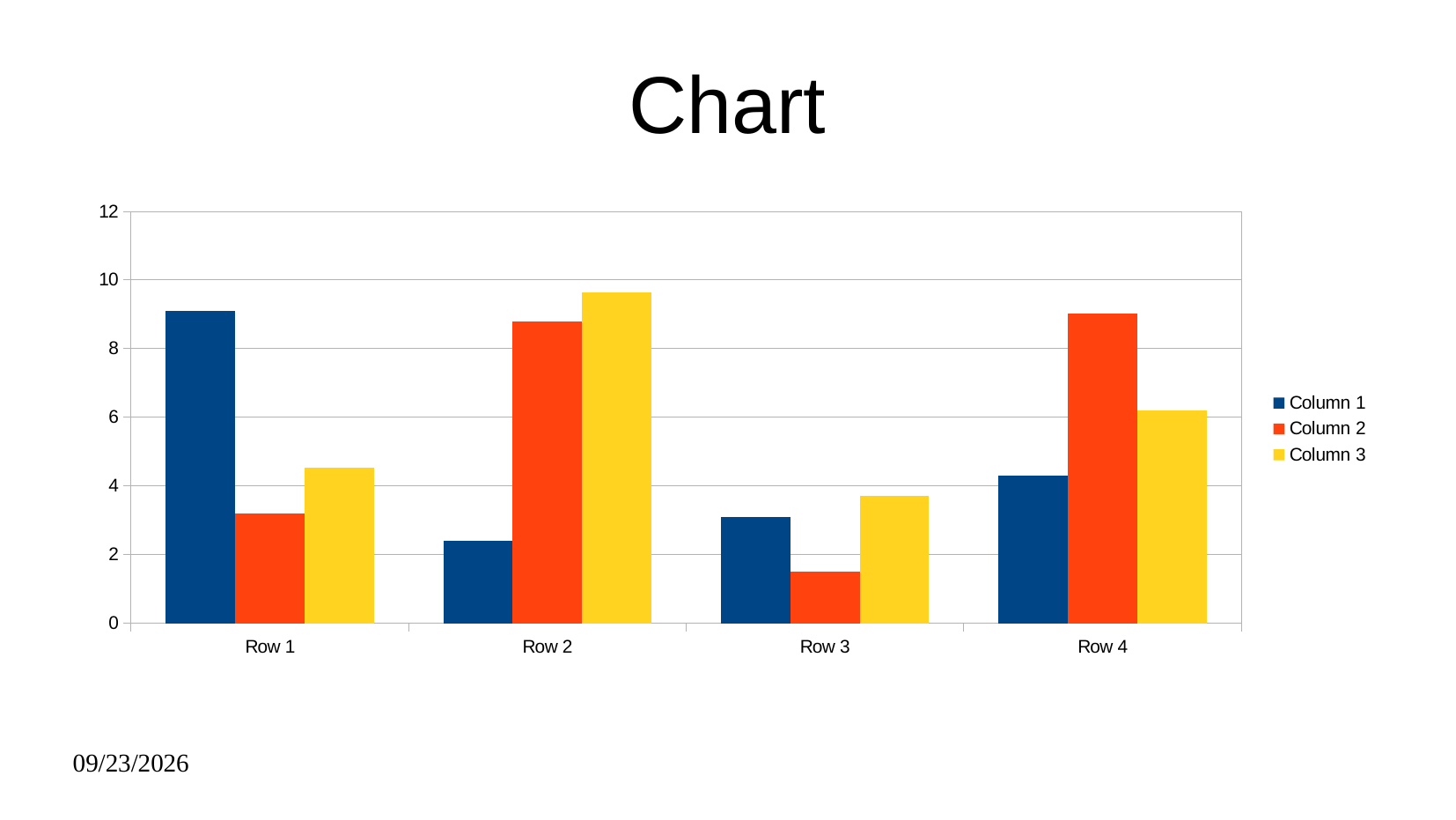
Is the value for Column 2 in Row 4 greater or less than 8? greater Which category has the highest value for Column 3? Row 2 What is the title of the chart? Chart In Row 2, which is larger: Column 1 or Column 3? Column 3 Which category has the highest value for Column 1? Row 1 Which category has the lowest value for Column 2? Row 3 How many categories are shown on the x axis? 4 Is the value for Column 1 in Row 1 greater or less than 8? greater What kind of chart is shown on the slide? bar chart Is the value for Column 1 in Row 2 greater or less than 4? less How many series does the legend list? 3